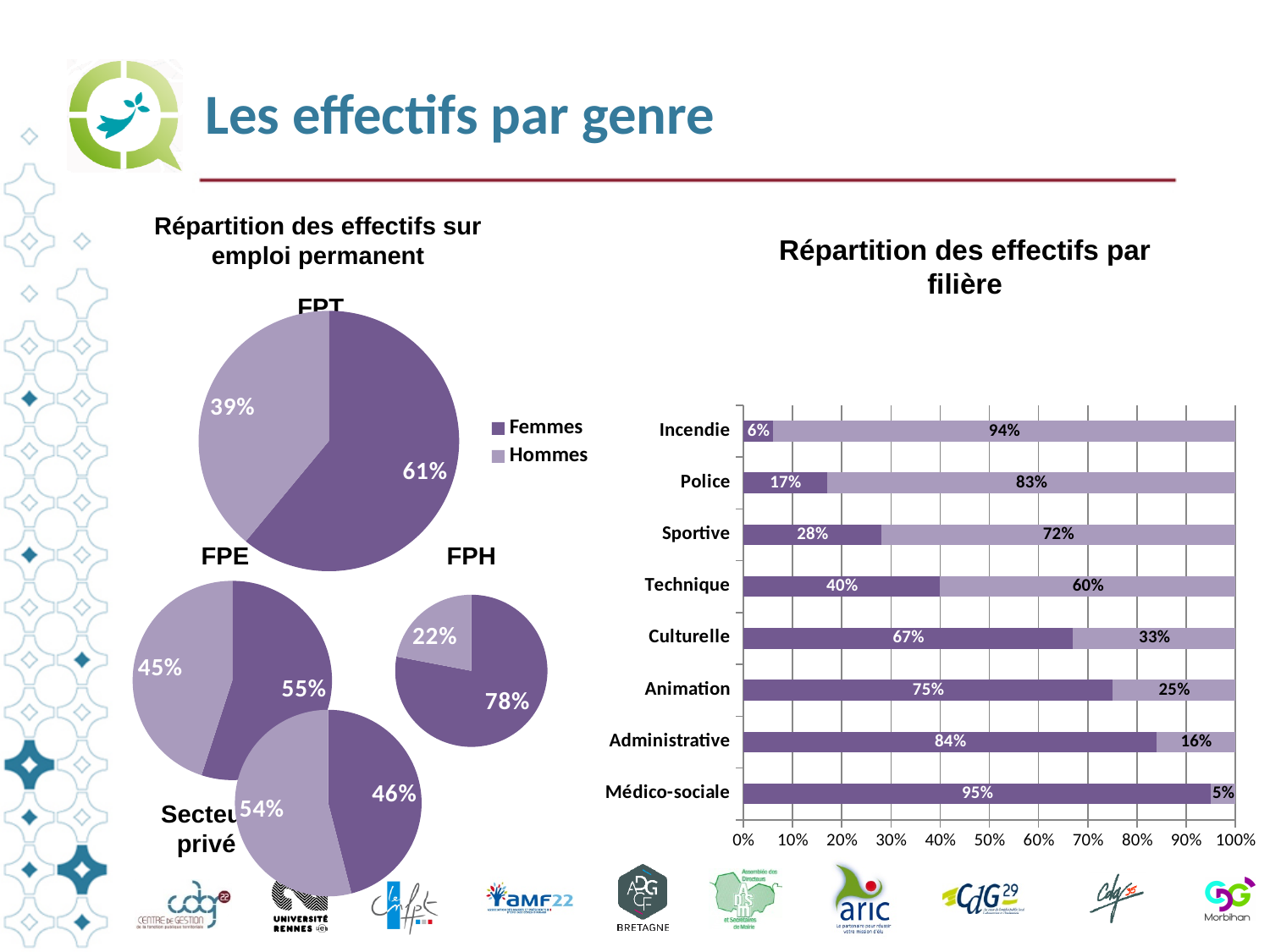
How many filières are listed in the 'Répartition des effectifs par filière' chart? 8 In the FPT pie chart, what is the share for Femmes? 61% What type of chart is 'Répartition des effectifs par filière'? Stacked bar chart In the 'Répartition des effectifs par filière' chart, which is larger: the Femmes share for Culturelle or the Femmes share for Animation? Animation In the FPH pie chart, what is the share for Hommes? 22% How many series does the legend next to the pie charts list? 2 In the Secteur privé pie chart, which is larger: Femmes or Hommes? Hommes In the 'Répartition des effectifs par filière' chart, what is the difference between the Hommes share for Police and the Hommes share for Sportive? 11% In the 'Répartition des effectifs par filière' chart, which filière has the lowest Femmes (dark purple) share? Incendie In the 'Répartition des effectifs par filière' chart, what is the Femmes (dark purple) share for Incendie? 6% In the 'Répartition des effectifs par filière' chart, what is the Hommes (light purple) share for Technique? 60% In the 'Répartition des effectifs par filière' chart, which filière has the highest Femmes (dark purple) share? Médico-sociale